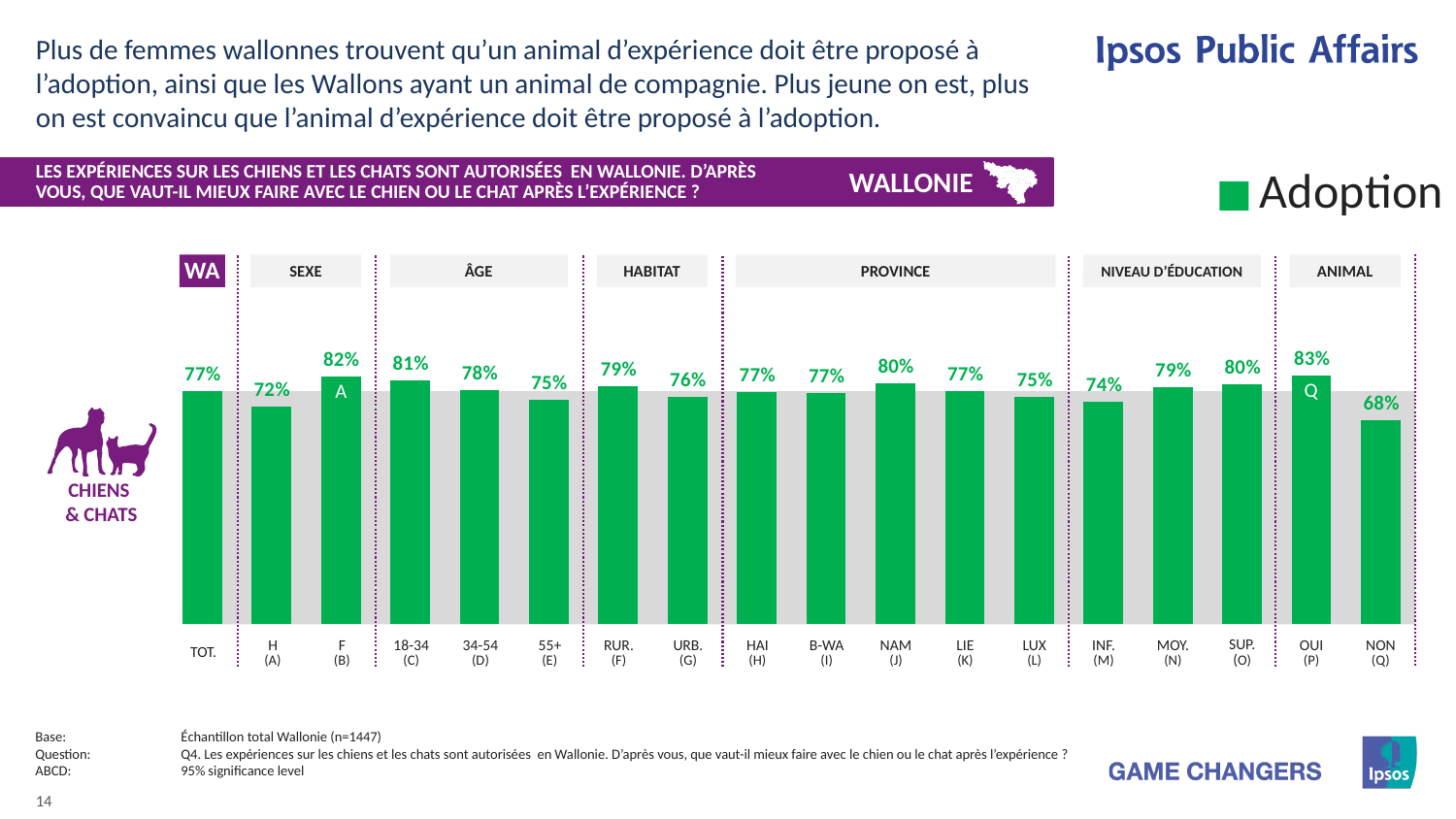
Which category has the highest value on the chart? OUI (P) What is the value for NON in the ANIMAL group? 68% Which category has the lowest value on the chart? NON (Q) What is the value for TOT. (the total Wallonie bar)? 77% Do the values rise or fall across the age groups from 18-34 to 55+? Fall What is the difference between the values for F and H in the SEXE group? 10 percentage points Which is larger, the value for RUR. or the value for URB.? RUR. What kind of chart is shown on the slide? Bar chart What is the value for F (women) in the SEXE group? 82% How many bars are plotted on the chart? 18 What is the value for the 18-34 age group? 81% How many series does the legend list? 1